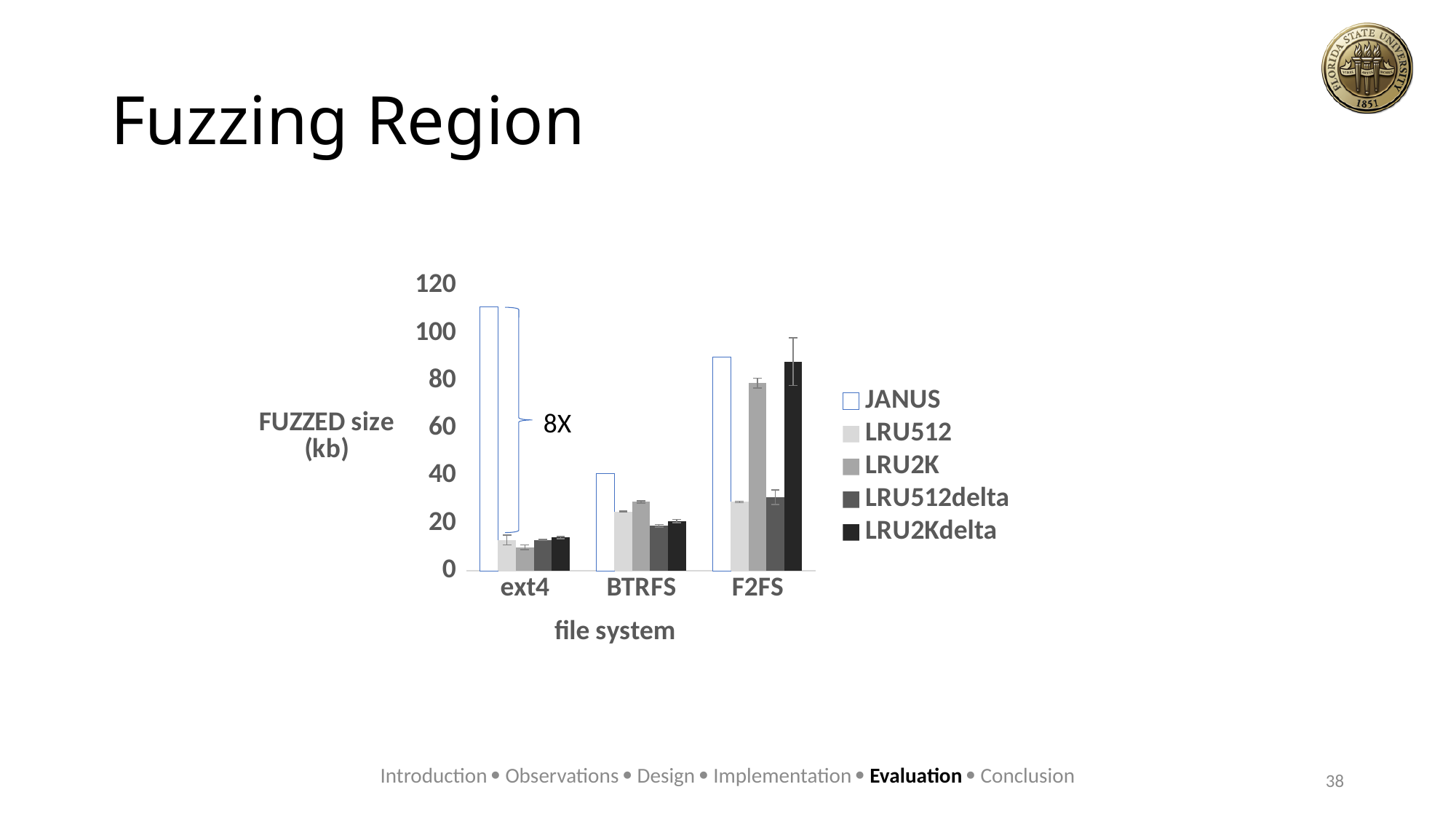
Which is larger for F2FS, the LRU2K bar or the LRU512 bar? LRU2K Is the LRU512 value for ext4 greater or less than 20? less How many series does the chart's legend list? 5 Is the JANUS value for BTRFS greater or less than 60? less Which file system has the highest JANUS bar? ext4 Is the JANUS value for ext4 greater or less than 100? greater What is the label on the y axis of the chart? FUZZED size (kb) Which file system has the lowest JANUS bar? BTRFS How many file systems are shown on the x axis of the chart? 3 What kind of chart is shown on the slide? bar chart What annotation is written next to the bracket on the ext4 group? 8X